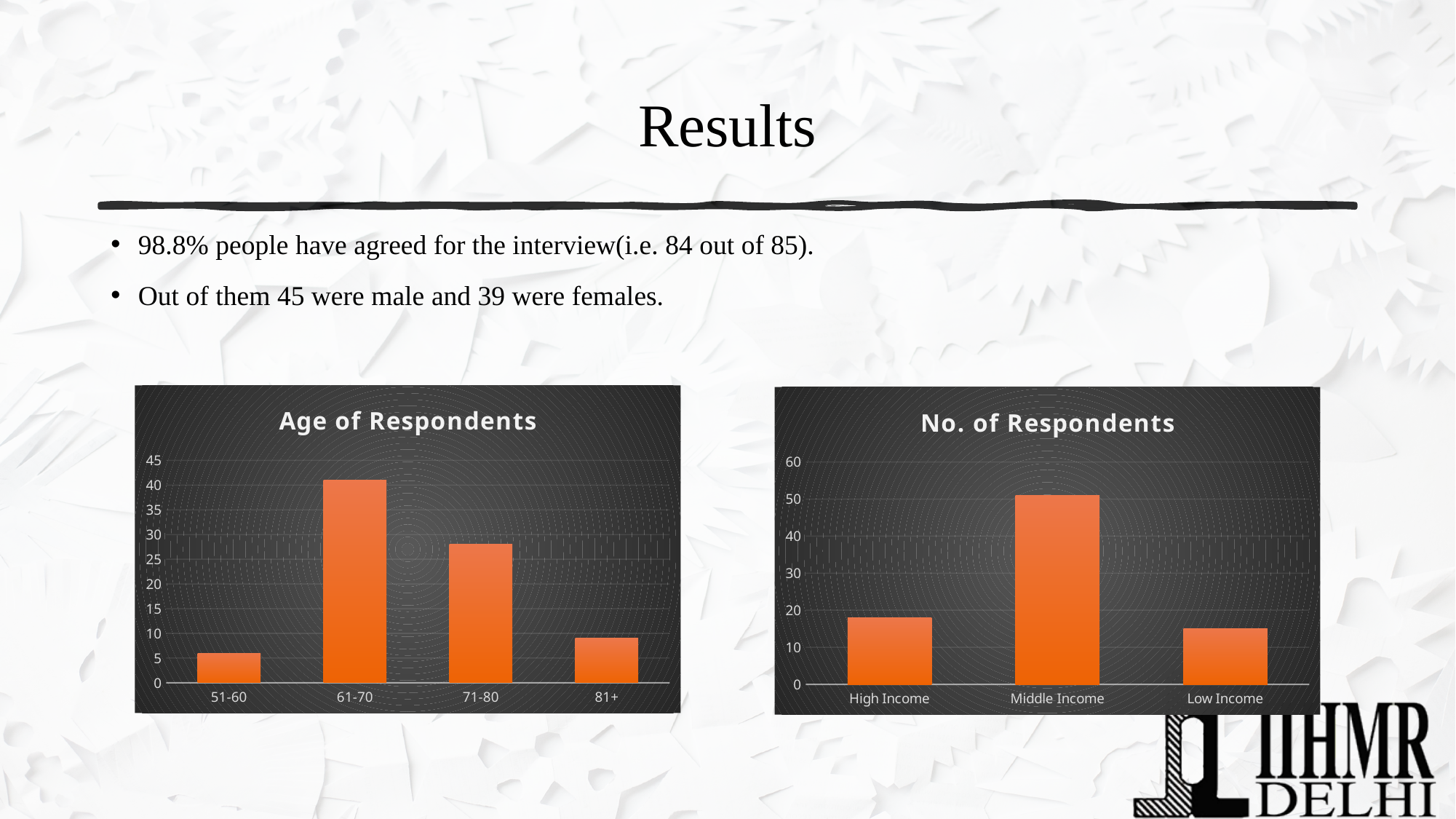
In the 'Age of Respondents' chart, is the value for 81+ greater or less than 5? greater In the 'No. of Respondents' chart, which income group has the highest value? Middle Income How many age groups are shown in the 'Age of Respondents' chart? 4 How many income categories are shown in the 'No. of Respondents' chart? 3 In the 'Age of Respondents' chart, which age group has the lowest value? 51-60 In the 'Age of Respondents' chart, which age group has the highest value? 61-70 In the 'Age of Respondents' chart, which is larger, the value for 71-80 or the value for 81+? 71-80 In the 'No. of Respondents' chart, is the value for Low Income greater or less than 20? less In the 'Age of Respondents' chart, is the value for 71-80 greater or less than 30? less What type of chart is the 'No. of Respondents' chart? Bar chart